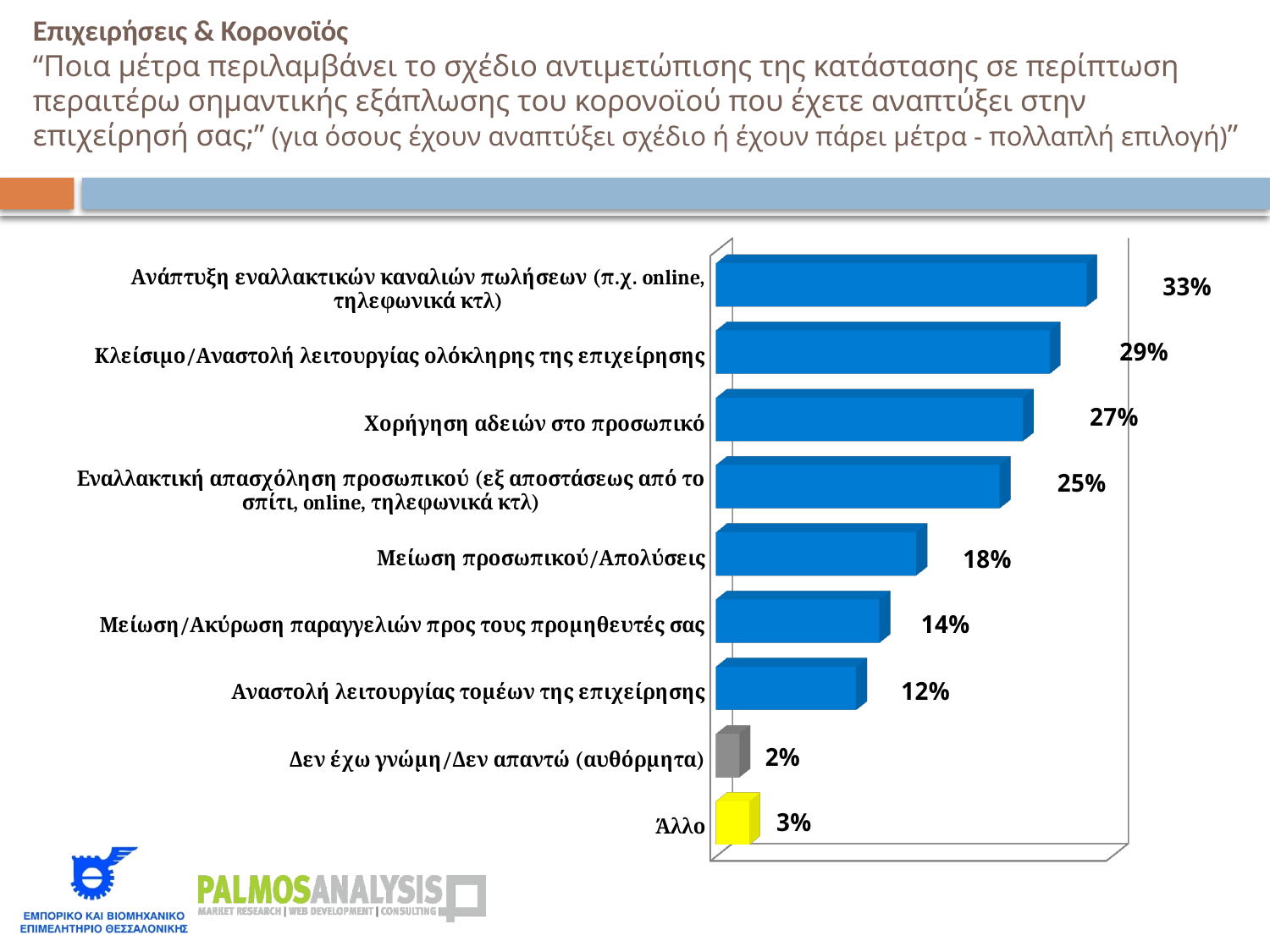
What value is shown for "Αναστολή λειτουργίας τομέων της επιχείρησης"? 12% What value is shown for "Χορήγηση αδειών στο προσωπικό"? 27% What is the difference between the values for "Κλείσιμο/Αναστολή λειτουργίας ολόκληρης της επιχείρησης" and "Μείωση/Ακύρωση παραγγελιών προς τους προμηθευτές σας"? 15% What value is shown for "Άλλο"? 3% How many categories are shown in the chart? 9 Which is larger: the value for "Εναλλακτική απασχόληση προσωπικού (εξ αποστάσεως από το σπίτι, online, τηλεφωνικά κτλ)" or for "Μείωση προσωπικού/Απολύσεις"? Εναλλακτική απασχόληση προσωπικού (εξ αποστάσεως από το σπίτι, online, τηλεφωνικά κτλ) What colour is the bar for "Άλλο"? Yellow Which category has the lowest value? Δεν έχω γνώμη/Δεν απαντώ (αυθόρμητα) What value is shown for "Μείωση προσωπικού/Απολύσεις"? 18% What colour is the bar for "Δεν έχω γνώμη/Δεν απαντώ (αυθόρμητα)"? Grey What kind of chart is shown on the slide? Bar chart Which category has the highest value? Ανάπτυξη εναλλακτικών καναλιών πωλήσεων (π.χ. online, τηλεφωνικά κτλ)